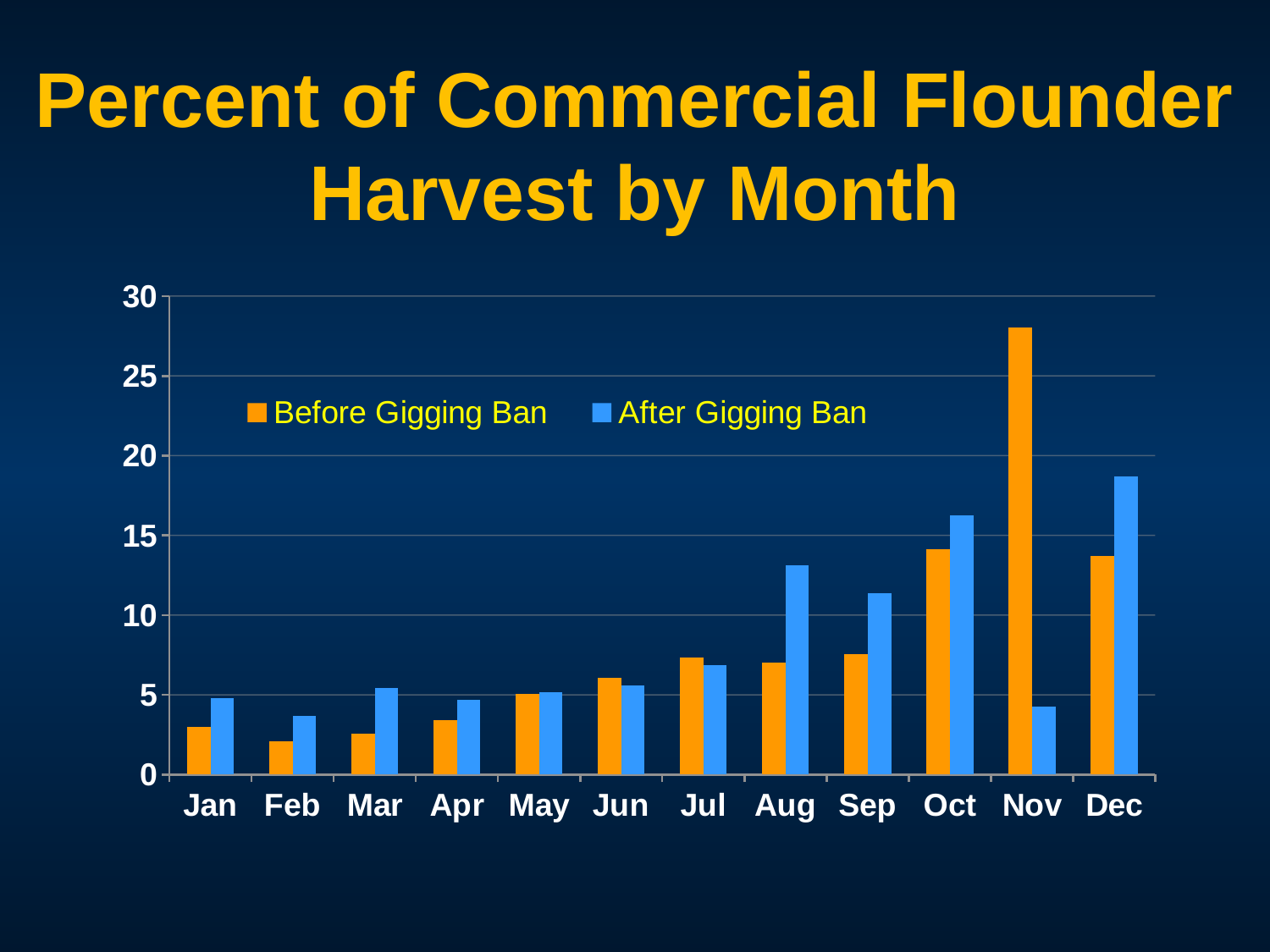
Is the Before Gigging Ban value for Nov greater or less than 25? greater Is the After Gigging Ban value for Oct greater or less than 15? greater In Nov, which series has the larger value, Before Gigging Ban or After Gigging Ban? Before Gigging Ban Which month has the highest value for After Gigging Ban? Dec How many series does the legend list? 2 Which month has the highest value for Before Gigging Ban? Nov Which month has the lowest value for Before Gigging Ban? Feb Is the After Gigging Ban value for Nov greater or less than 5? less What is the title of the chart? Percent of Commercial Flounder Harvest by Month In Aug, which series has the larger value, Before Gigging Ban or After Gigging Ban? After Gigging Ban What kind of chart is shown on the slide? bar chart How many months are shown on the x axis? 12